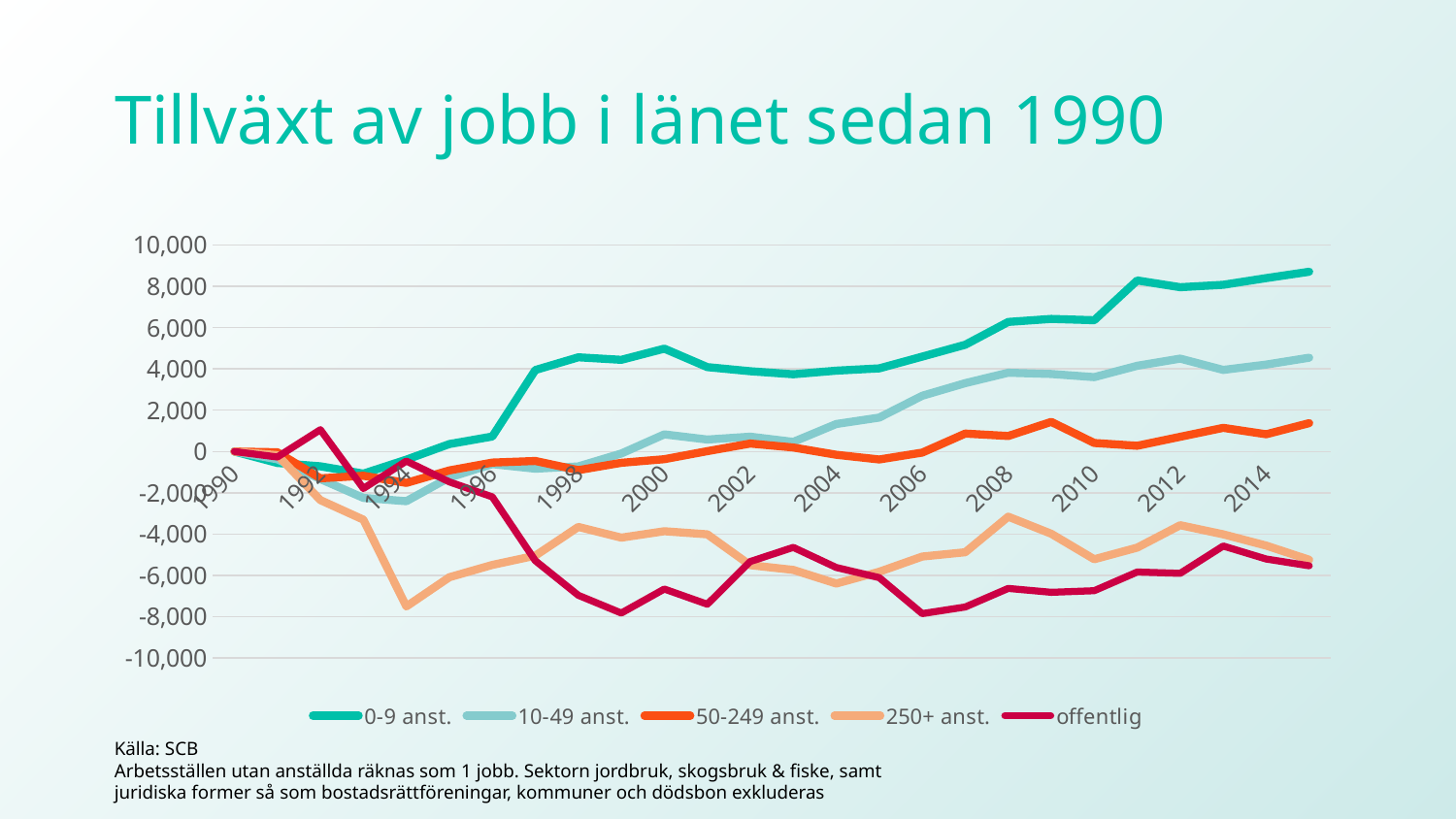
How many series does the legend list? 5 Which series has the highest value in 2014? 0-9 anst. What kind of chart is shown on the slide? line chart What is the value for 0-9 anst. in 1990? 0 Is the value for 250+ anst. in 1994 greater or less than -6,000? less What is the title of the chart? Tillväxt av jobb i länet sedan 1990 Which series is shown in dark red/magenta in the legend? offentlig Does the 0-9 anst. series rise or fall overall from 1990 to the end of the chart? rise Is the value for offentlig in 2000 greater or less than -4,000? less Which series has the lowest value in 2000? offentlig Is the value for 0-9 anst. in 2012 greater or less than 6,000? greater In 2010, which is larger: the value for 0-9 anst. or the value for 10-49 anst.? 0-9 anst.